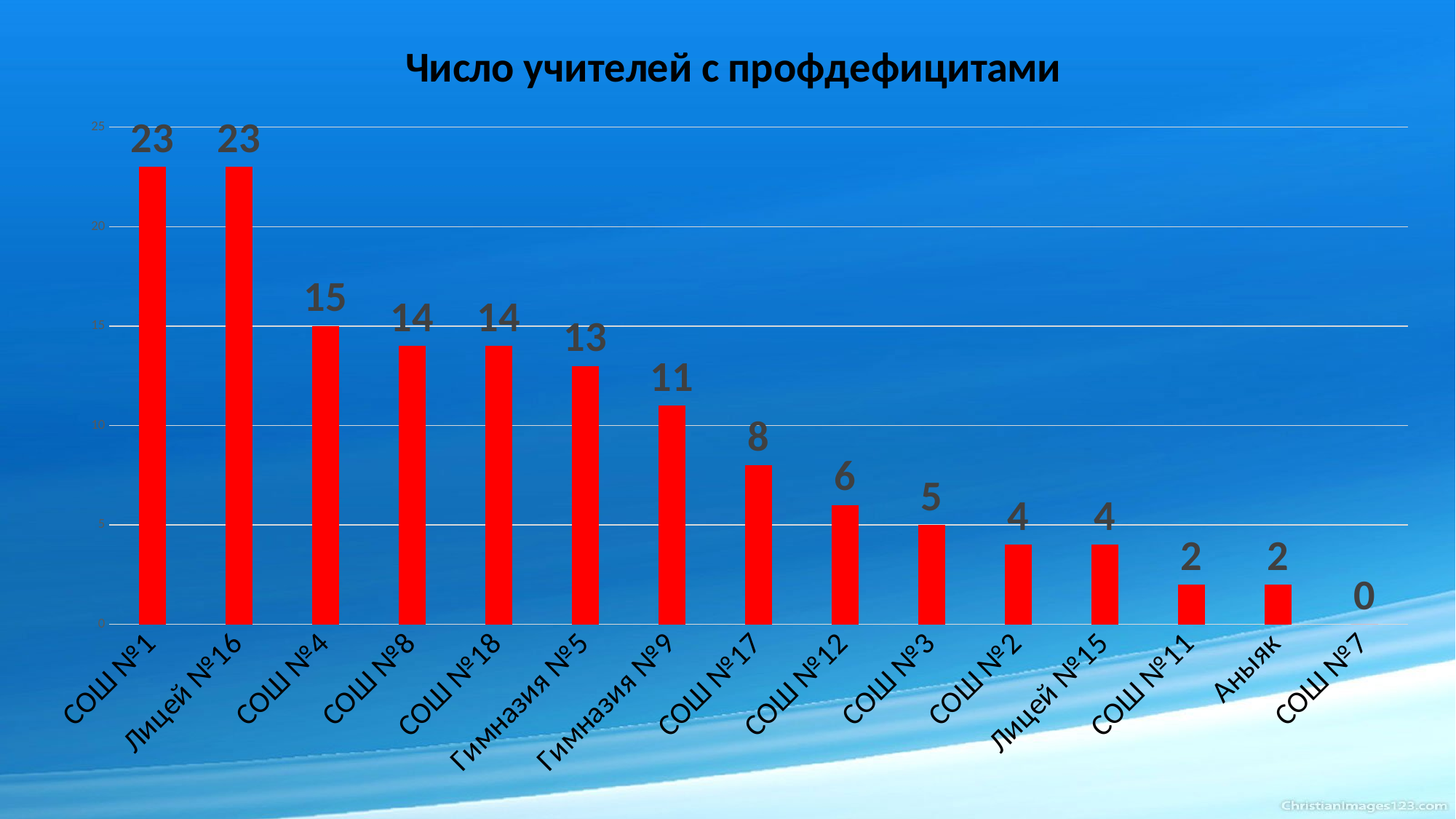
Which category has the lowest value? СОШ №7 What is the title of the chart? Число учителей с профдефицитами What is the value for Гимназия №9? 11 What is the value for СОШ №4? 15 What is the value for Аныяк? 2 What is the value for СОШ №17? 8 Do the values rise or fall from left to right along the x axis? fall What kind of chart is this? bar chart How many categories are shown in the chart? 15 What is the difference between the values for СОШ №1 and Гимназия №5? 10 Which is larger, the value for СОШ №12 or the value for СОШ №3? СОШ №12 What is the highest value shown in the chart? 23